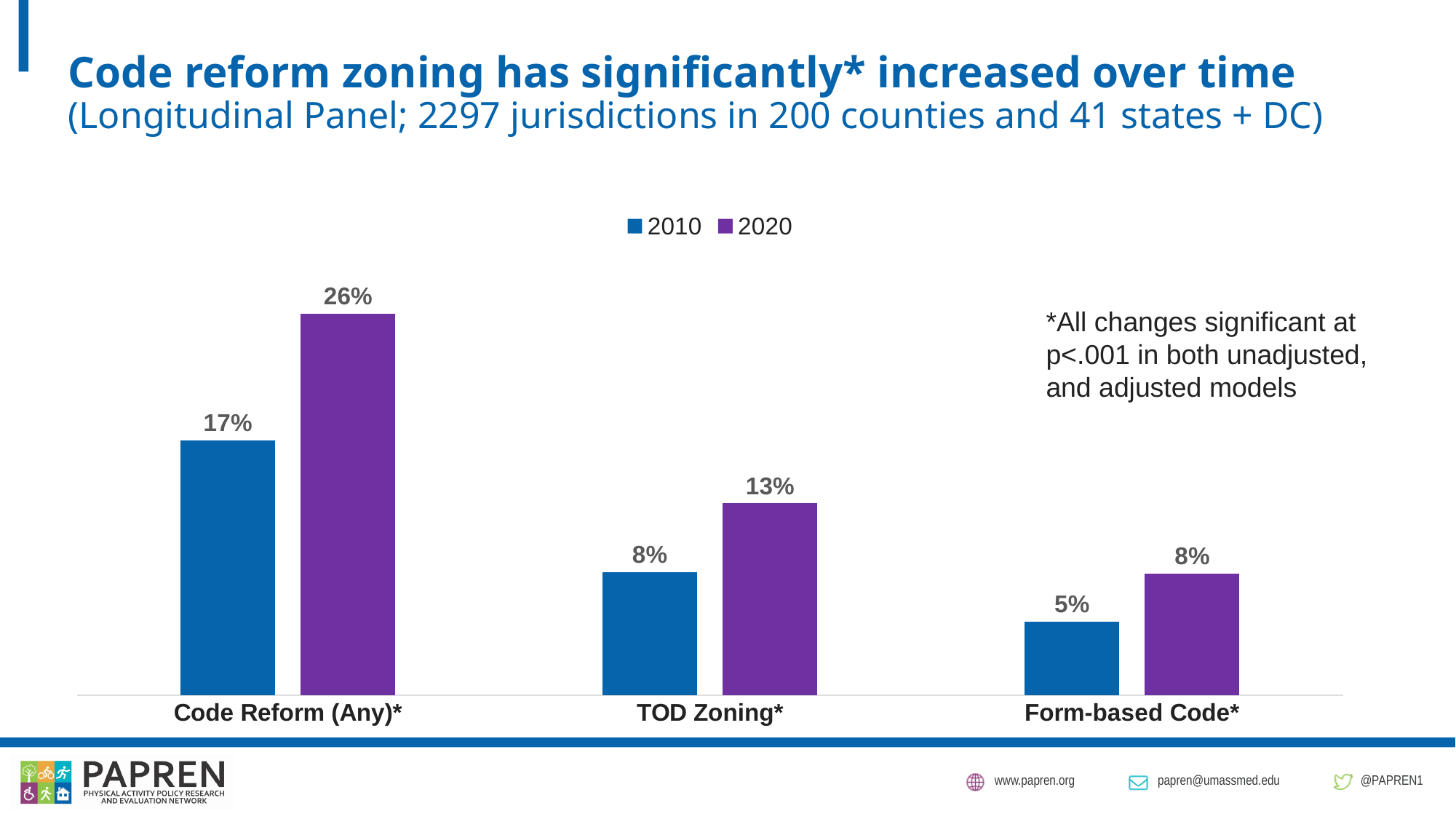
What is the 2010 value for TOD Zoning*? 8% What is the difference between the 2020 and 2010 values for TOD Zoning*? 5% Which is larger: the 2010 value for Code Reform (Any)* or the 2020 value for TOD Zoning*? 2010 value for Code Reform (Any)* What is the 2020 value for TOD Zoning*? 13% Which category has the lowest 2010 value? Form-based Code* Which category has the highest 2020 value? Code Reform (Any)* What is the difference between the 2020 and 2010 values for Code Reform (Any)*? 9% How many series does the legend list? 2 What is the 2020 value for Code Reform (Any)*? 26% What kind of chart is shown on the slide? Bar chart What is the 2010 value for Form-based Code*? 5% How many categories are shown on the x axis? 3